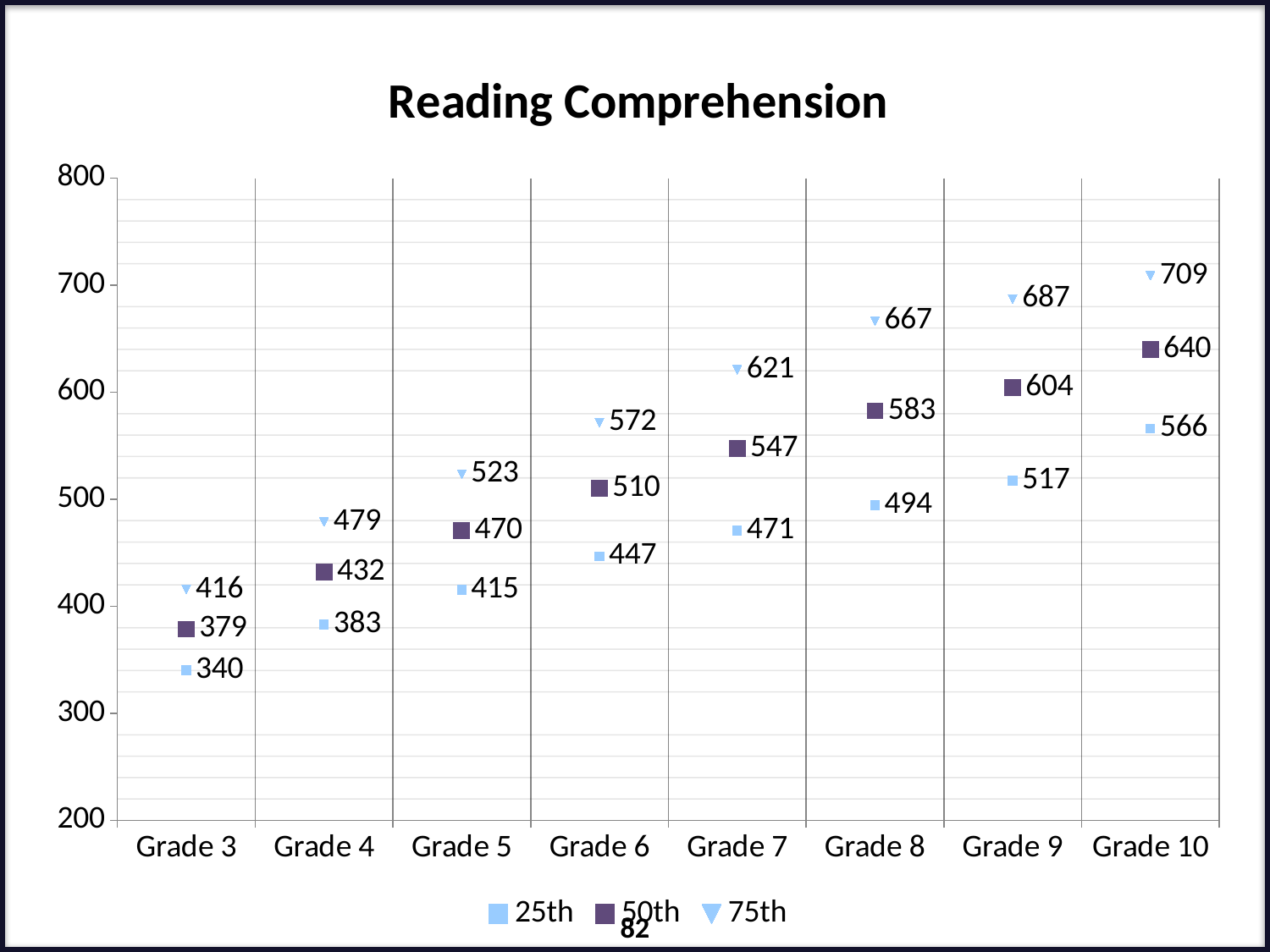
What is the 75th percentile value for Grade 8? 667 How many series does the legend list? 3 How many grades are shown on the x axis? 8 What is the 50th percentile value for Grade 6? 510 What is the difference between the 75th and 25th percentile values for Grade 10? 143 Which grade has the highest 75th percentile value? Grade 10 What is the title of the chart? Reading Comprehension Is the 50th percentile value for Grade 9 greater or less than 600? greater What is the 25th percentile value for Grade 3? 340 Which grade has the lowest 25th percentile value? Grade 3 Which is larger: the 50th percentile value for Grade 7 or the 75th percentile value for Grade 5? 50th percentile for Grade 7 Do the 50th percentile values rise or fall from Grade 3 to Grade 10? rise